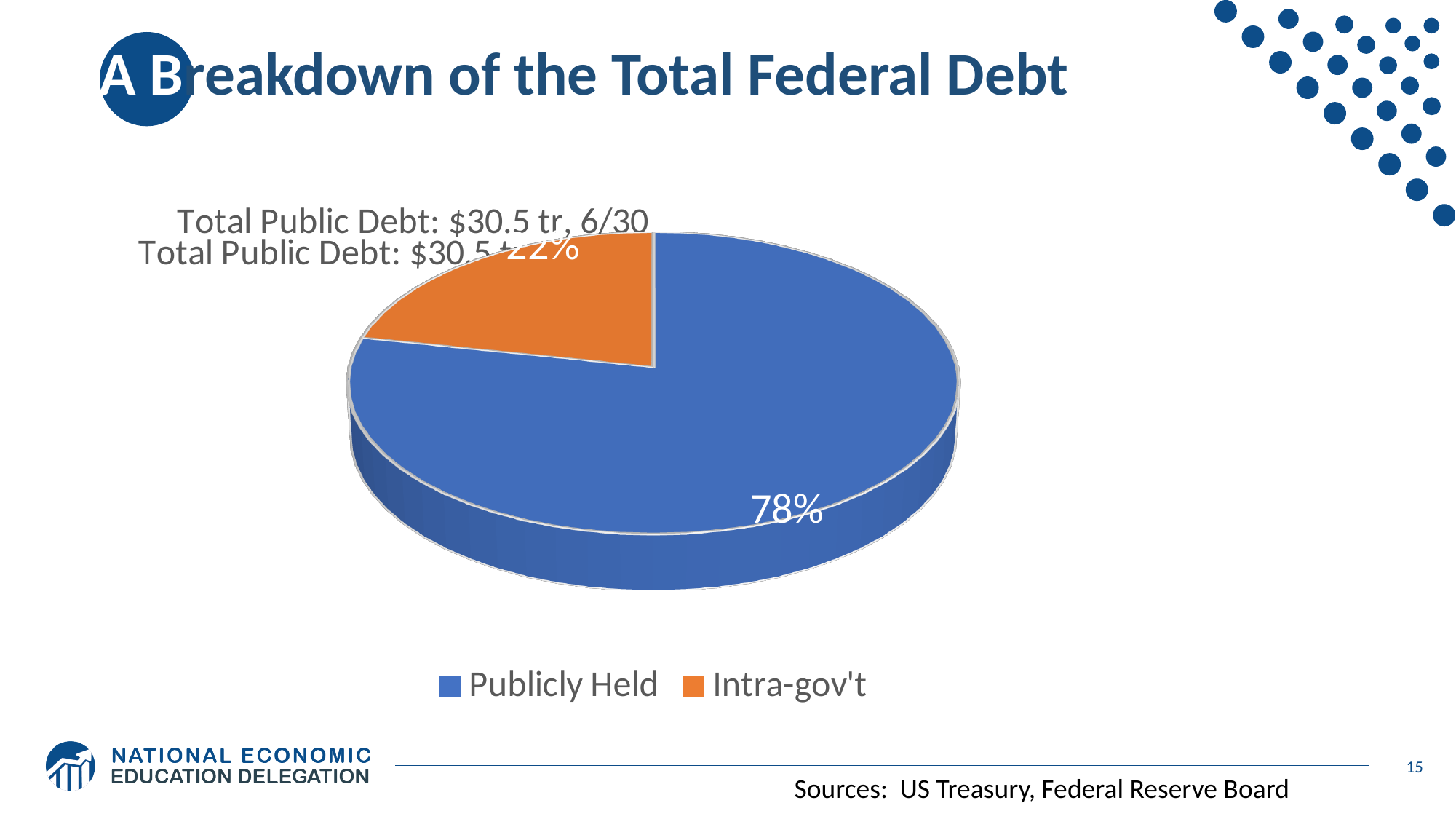
What total public debt amount is stated in the chart title? $30.5 tr Which slice of the pie is the smallest? Intra-gov't What kind of chart is shown on the slide? pie chart How many entries does the legend list? 2 Which is larger, the Publicly Held slice or the Intra-gov't slice? Publicly Held Which slice of the pie is the largest? Publicly Held How many slices does the pie chart have? 2 What share of the pie does the Intra-gov't slice represent? 22% What colour is the Intra-gov't slice? orange What share of the pie does the Publicly Held slice represent? 78% What is the difference in percentage points between the Publicly Held share and the Intra-gov't share? 56 Is the Publicly Held share greater or less than 50%? greater